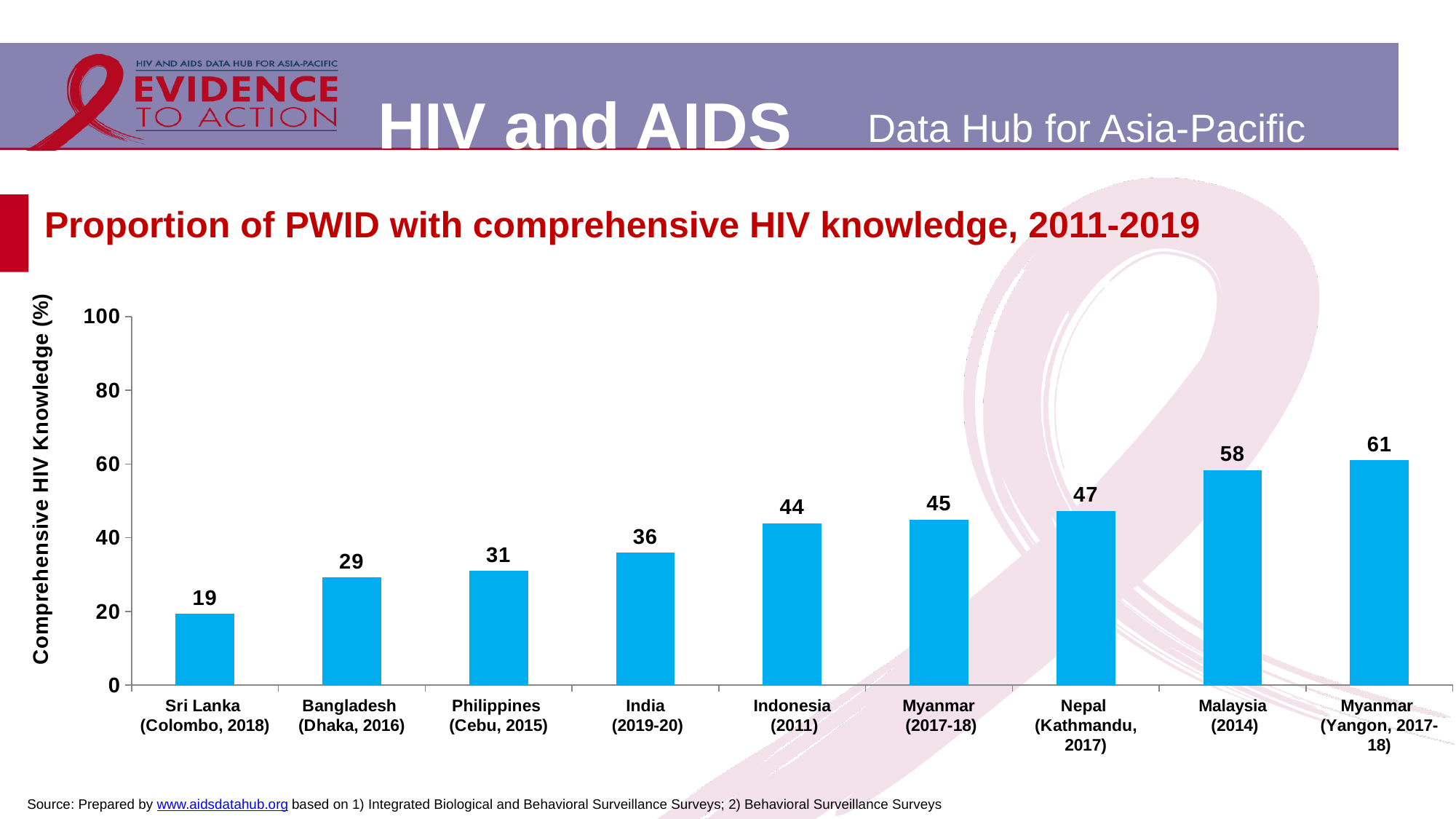
Is the value for Myanmar (2017-18) greater or less than 40? greater Which is larger, the value for India (2019-20) or the value for Philippines (Cebu, 2015)? India (2019-20) What kind of chart is shown on the slide? bar chart Which category has the lowest value? Sri Lanka (Colombo, 2018) What is the label of the y axis? Comprehensive HIV Knowledge (%) What is the value for Nepal (Kathmandu, 2017)? 47 Do the values rise or fall from left to right along the x axis? rise Which category has the highest value? Myanmar (Yangon, 2017-18) How many categories are shown on the x axis? 9 What is the value for Indonesia (2011)? 44 What is the value for Sri Lanka (Colombo, 2018)? 19 What is the difference between the values for Malaysia (2014) and Bangladesh (Dhaka, 2016)? 29